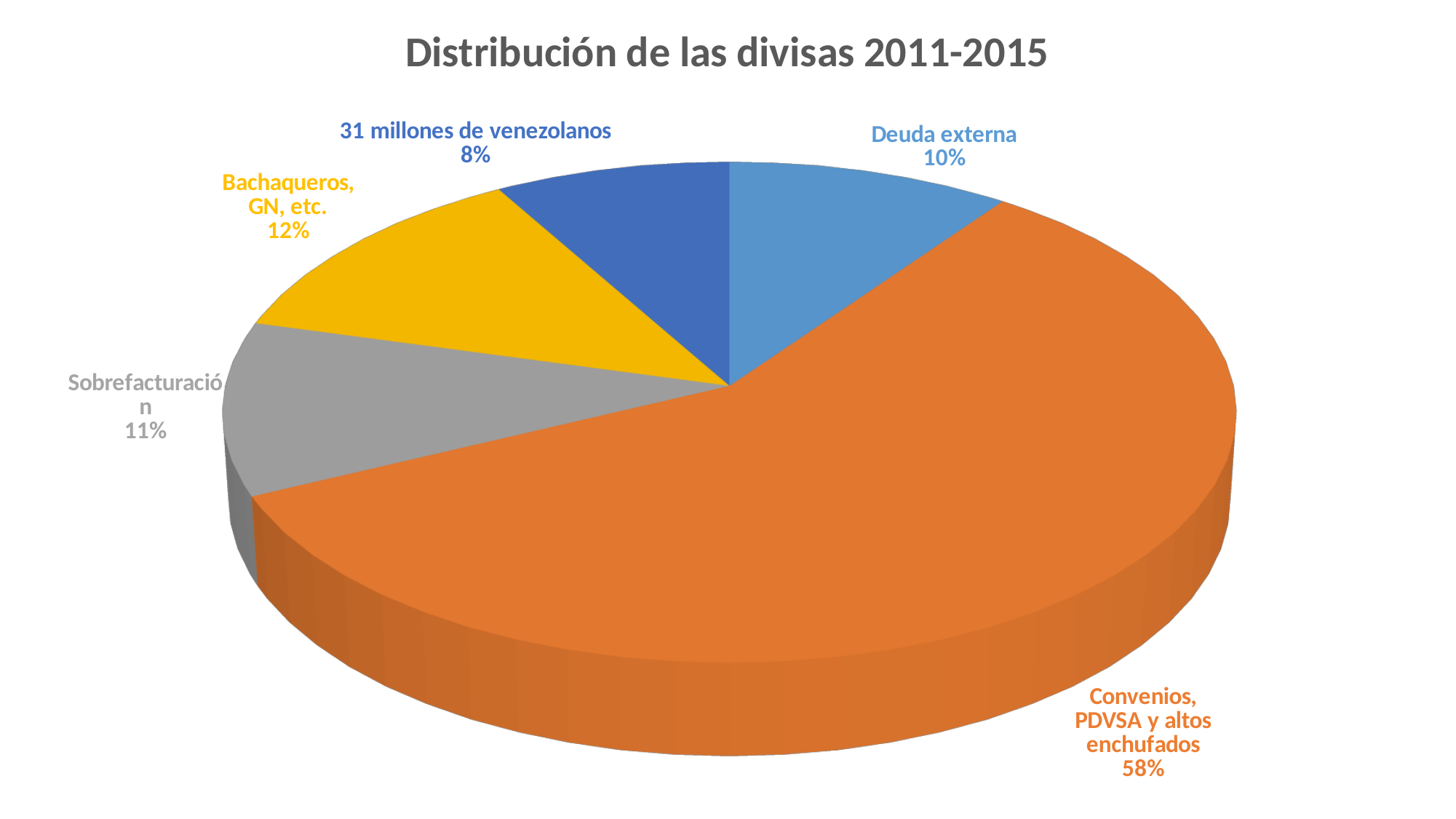
Which category has the smallest share of the pie? 31 millones de venezolanos What is the title of the chart? Distribución de las divisas 2011-2015 What share of the pie is labelled 'Deuda externa'? 10% What share of the pie is labelled 'Convenios, PDVSA y altos enchufados'? 58% What is the difference in percentage points between 'Convenios, PDVSA y altos enchufados' and 'Bachaqueros, GN, etc.'? 46 percentage points Which is larger, the share for 'Deuda externa' or the share for '31 millones de venezolanos'? Deuda externa Which category has the largest share of the pie? Convenios, PDVSA y altos enchufados What kind of chart is shown on the slide? Pie chart What share of the pie is labelled 'Sobrefacturación'? 11% How many slices does the pie chart have? 5